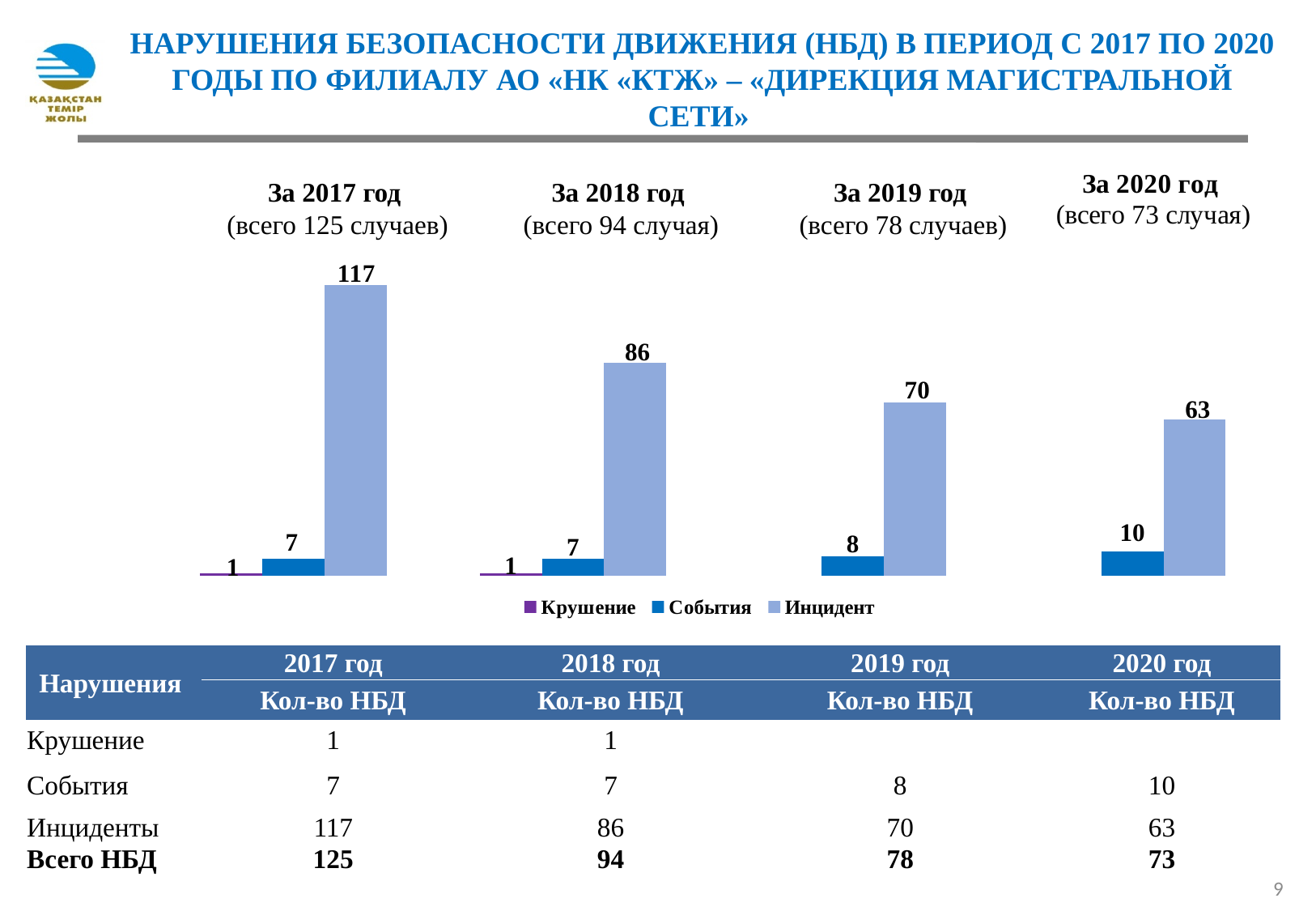
In which year is the Инцидент value the lowest? 2020 What is the difference between the Инцидент values for 2017 and 2018? 31 How many year groups are shown on the chart? 4 What is the total number of cases shown for 2019 (За 2019 год)? 78 Which is larger: the События value for 2019 or for 2020? 2020 What is the value for События in 2020 (За 2020 год)? 10 How many series does the chart legend list? 3 In which year is the Инцидент value the highest? 2017 What is the value for Инцидент in 2017 (За 2017 год)? 117 What type of chart is shown on the slide? bar chart What is the value for Крушение in 2018 (За 2018 год)? 1 Do the Инцидент values rise or fall from 2017 to 2020? fall